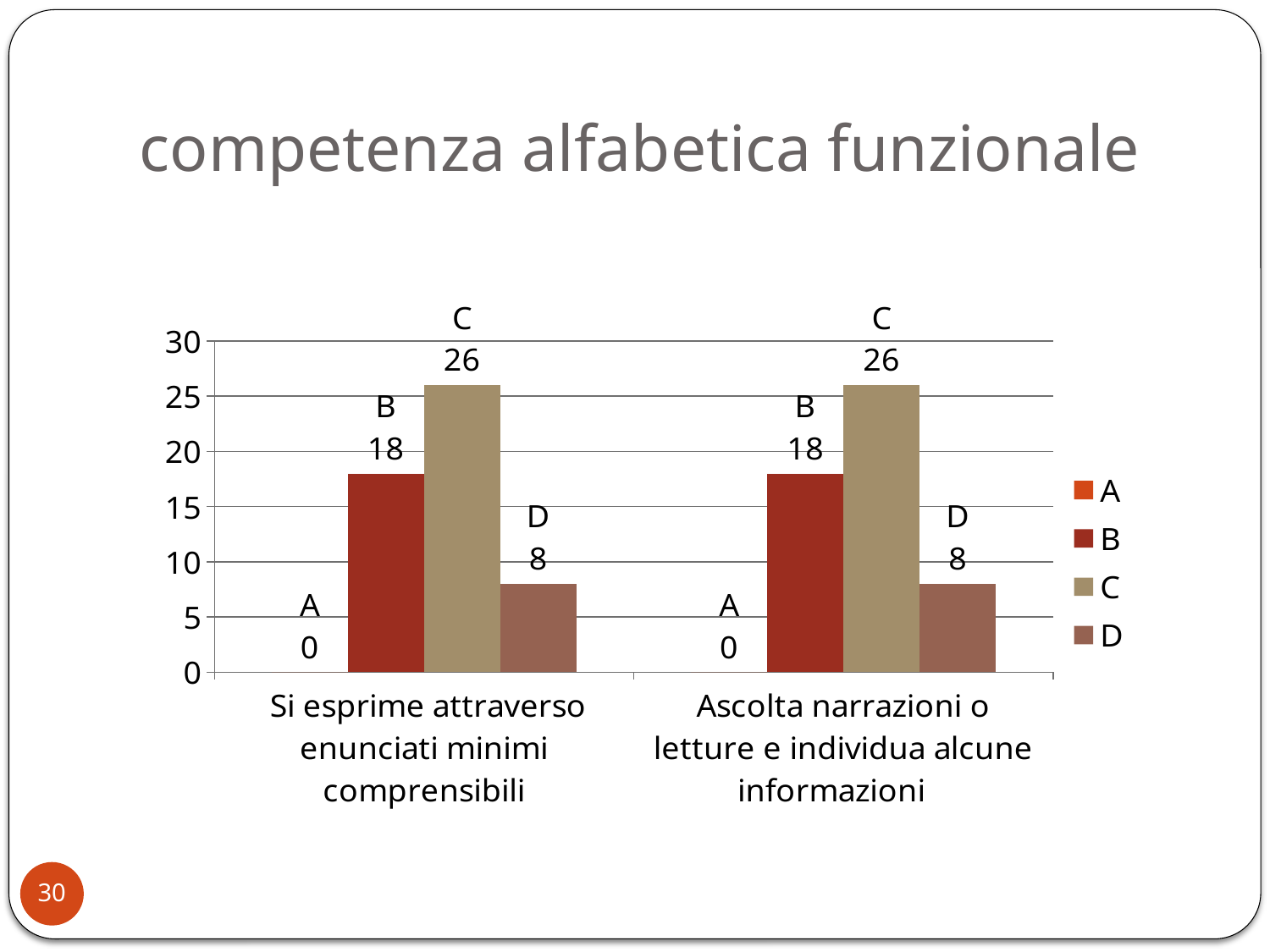
What is the difference between the values for series C and series B in the category "Si esprime attraverso enunciati minimi comprensibili"? 8 How many categories are shown on the x axis? 2 Which series has the lowest value in the category "Ascolta narrazioni o letture e individua alcune informazioni"? A What is the value for series D in the category "Si esprime attraverso enunciati minimi comprensibili"? 8 What is the value for series C in the category "Si esprime attraverso enunciati minimi comprensibili"? 26 What kind of chart is shown on the slide? Bar chart How many series does the legend list? 4 What is the difference between the values for series B and series D in the category "Ascolta narrazioni o letture e individua alcune informazioni"? 10 What is the value for series B in the category "Ascolta narrazioni o letture e individua alcune informazioni"? 18 Which is larger in the category "Si esprime attraverso enunciati minimi comprensibili": the value for series B or the value for series D? B What is the value for series A in the category "Ascolta narrazioni o letture e individua alcune informazioni"? 0 Which series has the highest value in the category "Si esprime attraverso enunciati minimi comprensibili"? C